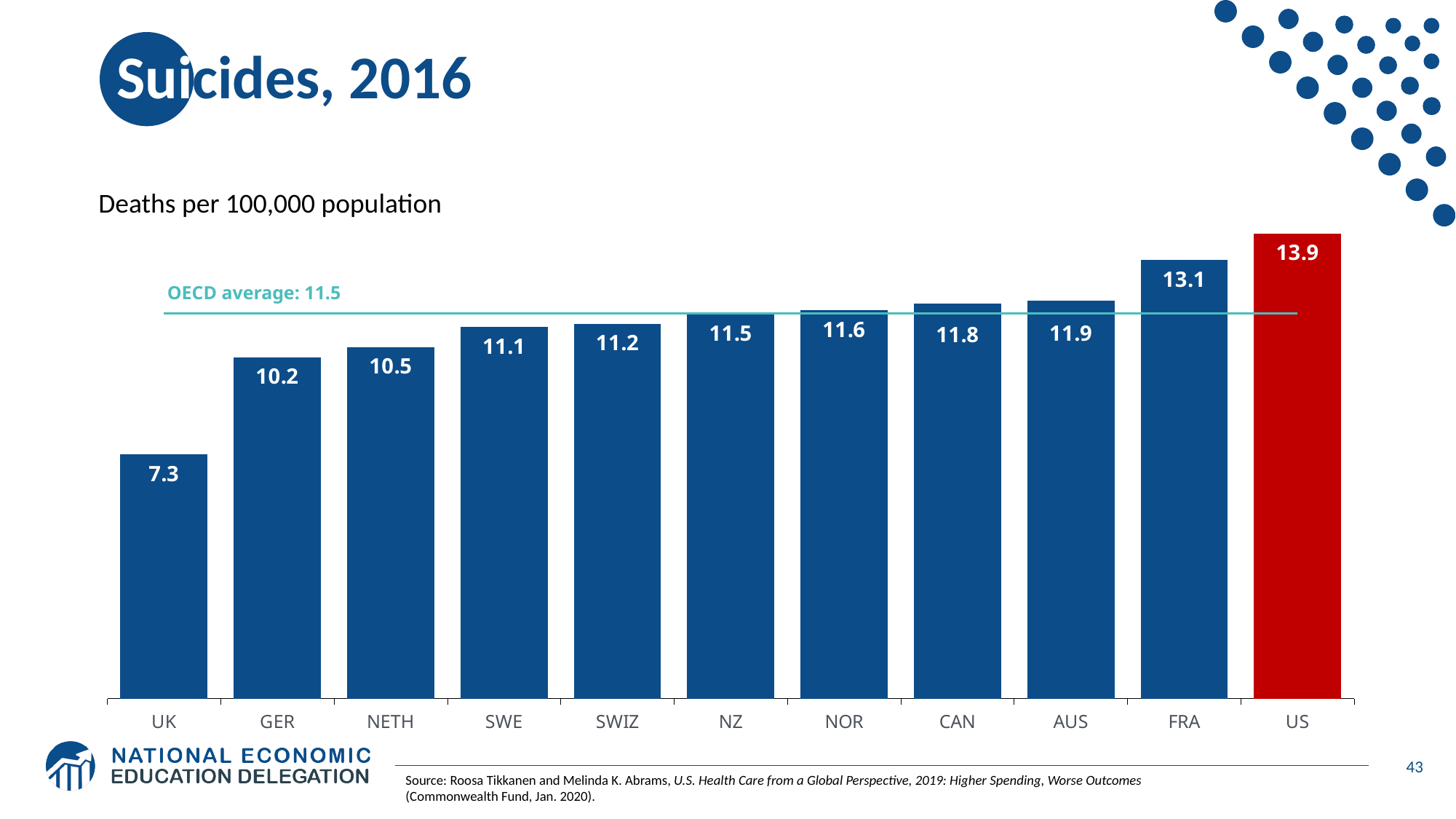
How much higher is France's value than Australia's? 1.2 Which has a higher value, Sweden (SWE) or the Netherlands (NETH)? SWE Which country has the highest suicide rate on the chart? US How many countries are shown on the chart? 11 What value is shown for Norway (NOR)? 11.6 Do the values rise or fall moving from left to right across the chart? Rise What type of chart is shown on the slide? Bar chart What is the suicide rate shown for the US? 13.9 What is the difference between the US value and the UK value? 6.6 What is the value shown for Germany (GER)? 10.2 What OECD average value is marked by the horizontal line on the chart? 11.5 Which country has the lowest suicide rate on the chart? UK